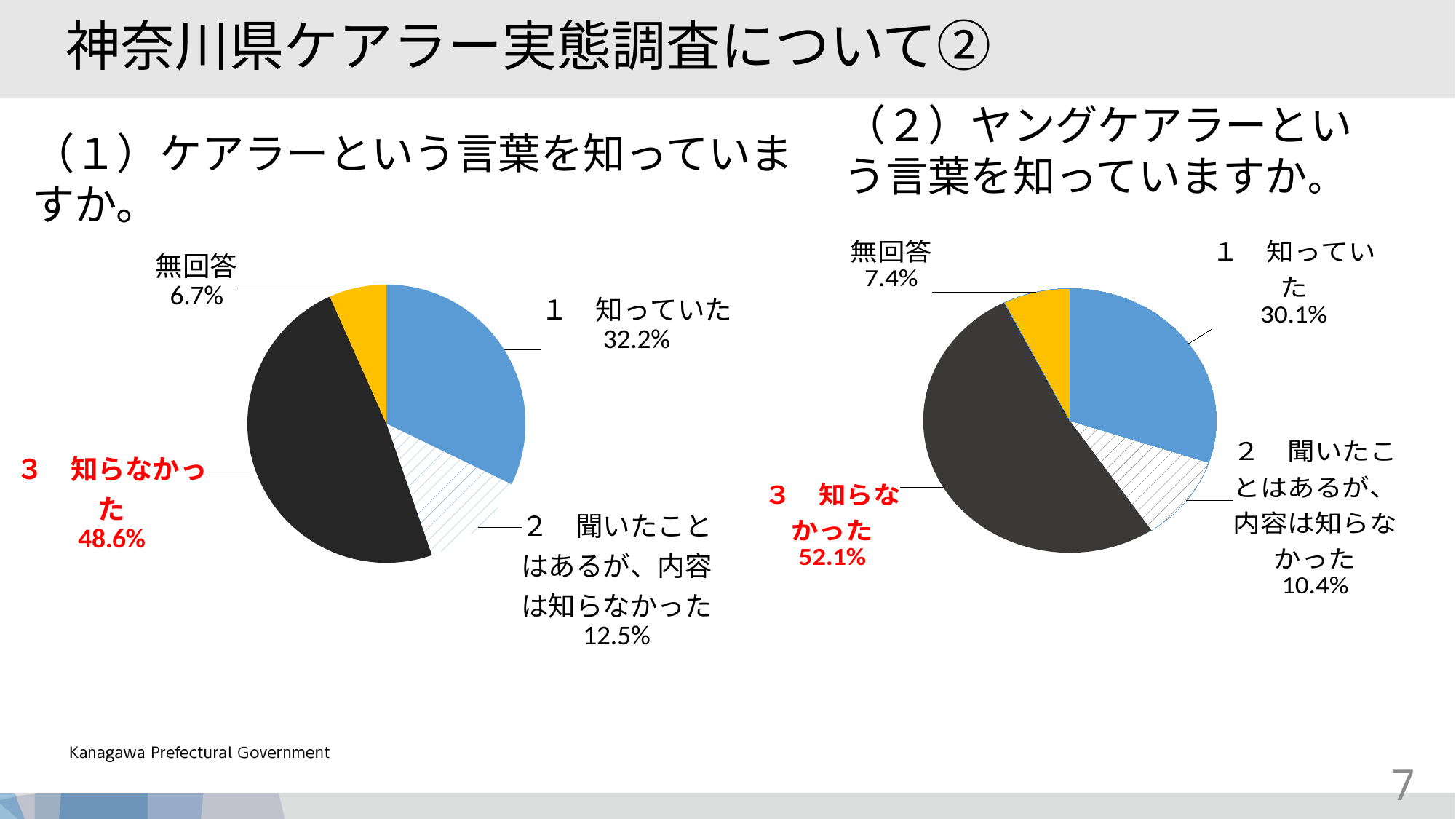
In the left pie chart, what is the difference between the share for 「知っていた」 and the share for 「聞いたことはあるが、内容は知らなかった」? 19.7% What type of chart is used on this slide? Pie chart In the right pie chart, what is the difference between the share for 「知らなかった」 and the share for 「知っていた」? 22.0% In the right pie chart, what colour is the 「知っていた」 slice? Blue In the right pie chart, which response has the smallest share? 無回答 In the left pie chart, which response has the largest share? 3 知らなかった In the right pie chart (ヤングケアラーという言葉を知っていますか), what percentage answered 「聞いたことはあるが、内容は知らなかった」? 10.4% Which is larger: the 「知らなかった」 share in the left pie chart or the 「知らなかった」 share in the right pie chart? The right pie chart (52.1%) How many slices does the left pie chart have? 4 In the right pie chart (ヤングケアラーという言葉を知っていますか), what percentage is 「無回答」? 7.4% In the left pie chart (ケアラーという言葉を知っていますか), what percentage answered 「知らなかった」? 48.6% In the left pie chart (ケアラーという言葉を知っていますか), what percentage answered 「知っていた」? 32.2%